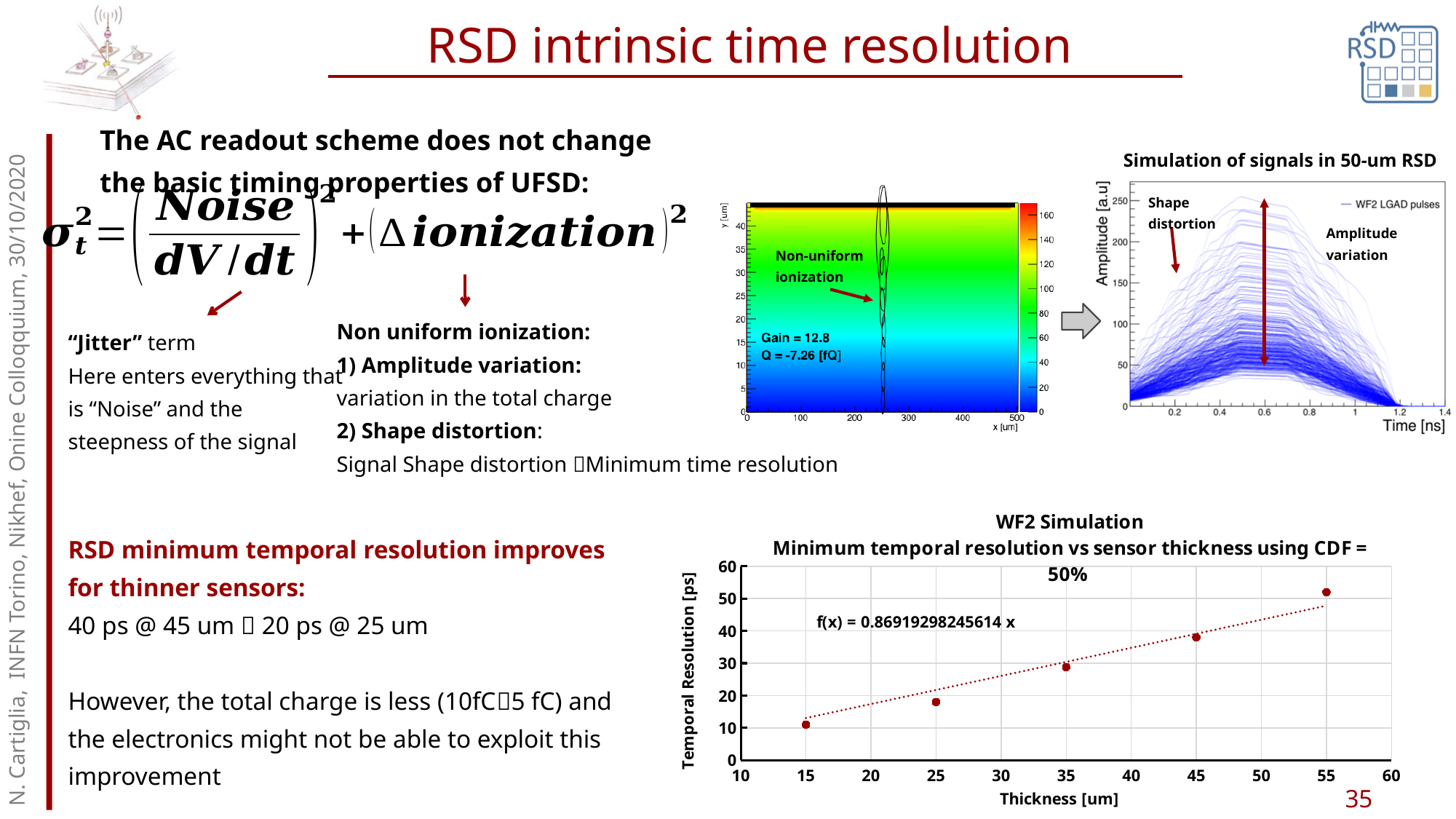
In the WF2 Simulation chart, at which thickness is the temporal resolution highest? 55 um In the WF2 Simulation chart, does the temporal resolution rise or fall as sensor thickness increases? rise In the WF2 Simulation chart, is the temporal resolution at 45 um thickness greater or less than 40 ps? less In the WF2 Simulation chart, what is the equation of the fitted trend line shown? f(x) = 0.86919298245614 x In the WF2 Simulation chart, is the temporal resolution at 55 um thickness greater or less than 50 ps? greater In the WF2 Simulation chart, what kind of chart is used to plot temporal resolution against thickness? scatter chart In the WF2 Simulation chart, is the temporal resolution at 15 um thickness greater or less than 20 ps? less In the WF2 Simulation chart, at which thickness is the temporal resolution lowest? 15 um In the WF2 Simulation chart, which has the larger temporal resolution: the point at 45 um or the point at 25 um? 45 um In the WF2 Simulation chart, what is the label of the y axis? Temporal Resolution [ps] In the WF2 Simulation chart, how many data points are plotted? 5